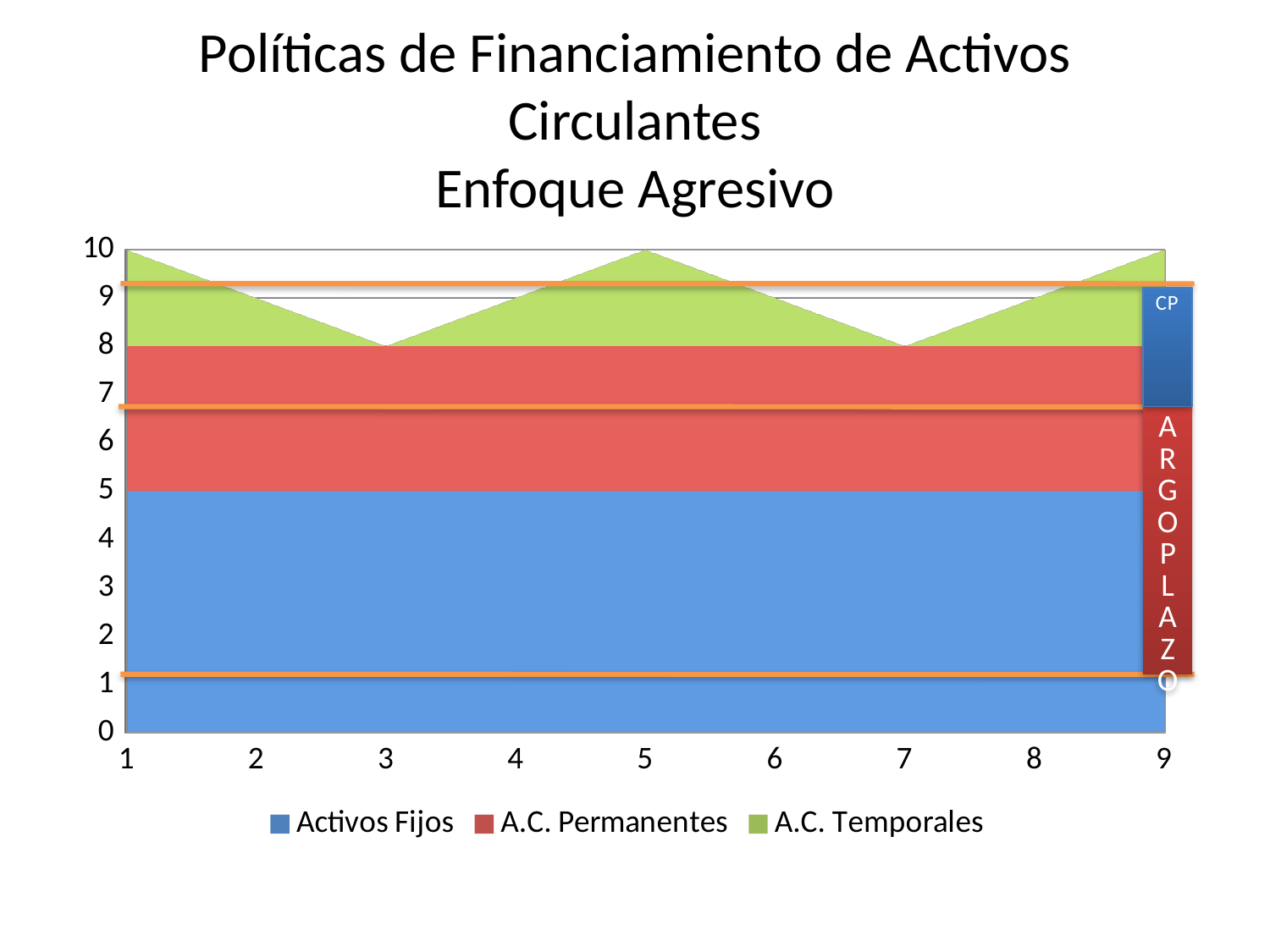
What kind of chart is shown on the slide? Stacked area chart What is the total stacked height of all three series at point 3? 8 How many series does the legend list? 3 Does the Activos Fijos series rise, fall, or stay flat along the x axis? Stays flat At what level does the top of the A.C. Permanentes area sit across the chart? 8 Which is larger, the total stacked height at point 1 or at point 3? Point 1 What is the value of Activos Fijos at point 1? 5 Is the total stacked height at point 7 greater or less than 9? less Is the total stacked height at point 9 greater or less than 9? greater Which series is shown in green in the legend? A.C. Temporales How many points are there along the x axis? 9 What is the total stacked height of all three series at point 5? 10